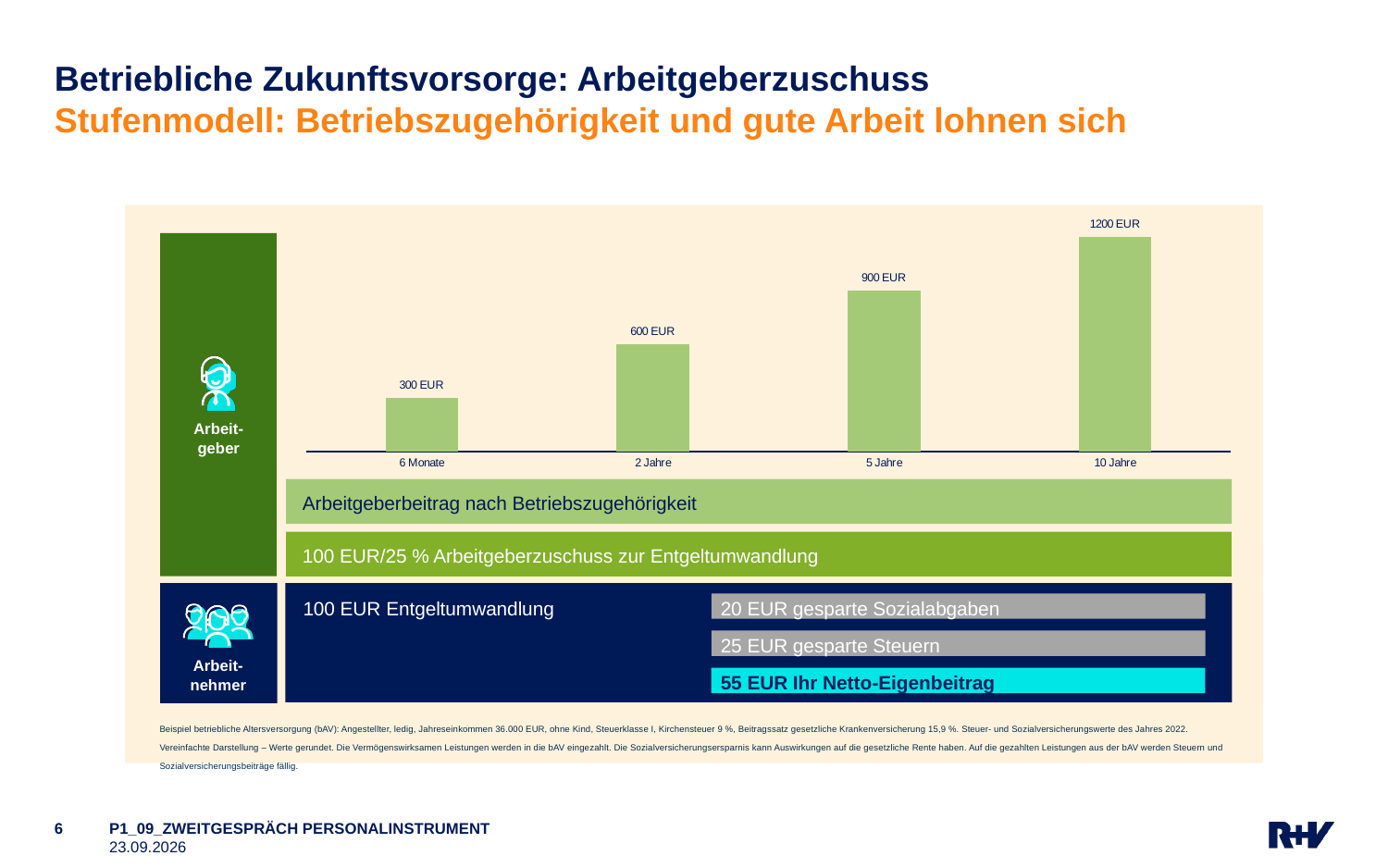
How many categories are shown on the x axis? 4 What is the value for 2 Jahre? 600 EUR Which category has the highest value? 10 Jahre What is the difference between the values for 5 Jahre and 2 Jahre? 300 EUR What kind of chart is shown? bar chart What is the value for 10 Jahre? 1200 EUR Which category has the lowest value? 6 Monate What is the value for 5 Jahre? 900 EUR What is the difference between the values for 10 Jahre and 6 Monate? 900 EUR What is the value for 6 Monate? 300 EUR Which is larger, the value for 2 Jahre or the value for 5 Jahre? 5 Jahre Do the values rise or fall from 6 Monate to 10 Jahre? rise